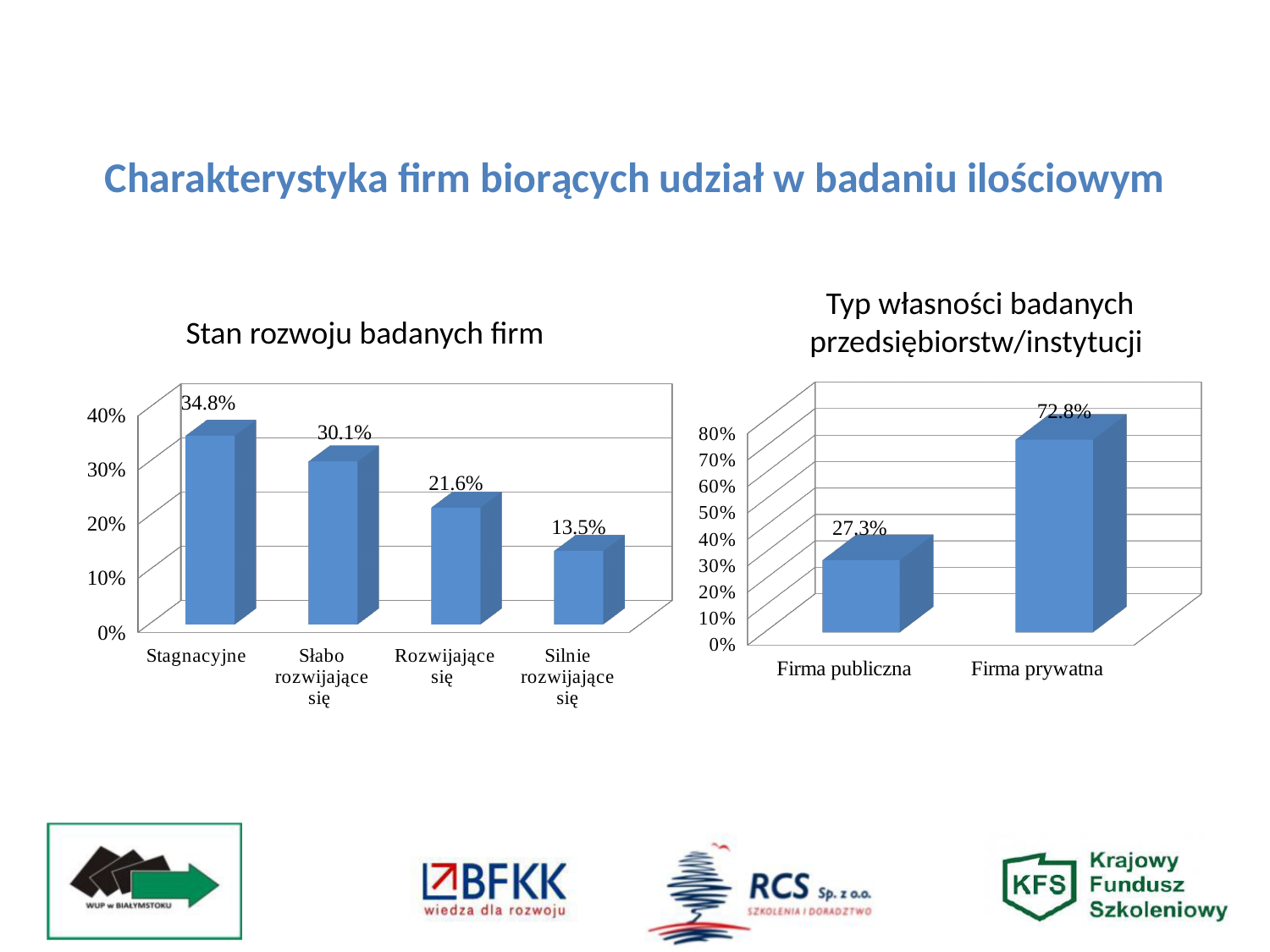
In the chart titled 'Stan rozwoju badanych firm', what is the difference between Słabo rozwijające się and Rozwijające się? 8.5% In the chart titled 'Stan rozwoju badanych firm', what is the value for Silnie rozwijające się? 13.5% What kind of chart is the chart on the right of the slide? bar chart In the chart titled 'Stan rozwoju badanych firm', which category has the lowest value? Silnie rozwijające się In the chart titled 'Stan rozwoju badanych firm', how many categories are shown? 4 In the chart titled 'Typ własności badanych przedsiębiorstw/instytucji', which is larger, Firma publiczna or Firma prywatna? Firma prywatna In the chart titled 'Stan rozwoju badanych firm', what is the value for Stagnacyjne? 34.8% In the chart titled 'Typ własności badanych przedsiębiorstw/instytucji', what is the value for Firma publiczna? 27.3% In the chart titled 'Typ własności badanych przedsiębiorstw/instytucji', what is the difference between Firma prywatna and Firma publiczna? 45.5% In the chart titled 'Stan rozwoju badanych firm', do the values rise or fall from left to right? fall In the chart titled 'Stan rozwoju badanych firm', which category has the highest value? Stagnacyjne In the chart titled 'Typ własności badanych przedsiębiorstw/instytucji', what is the value for Firma prywatna? 72.8%